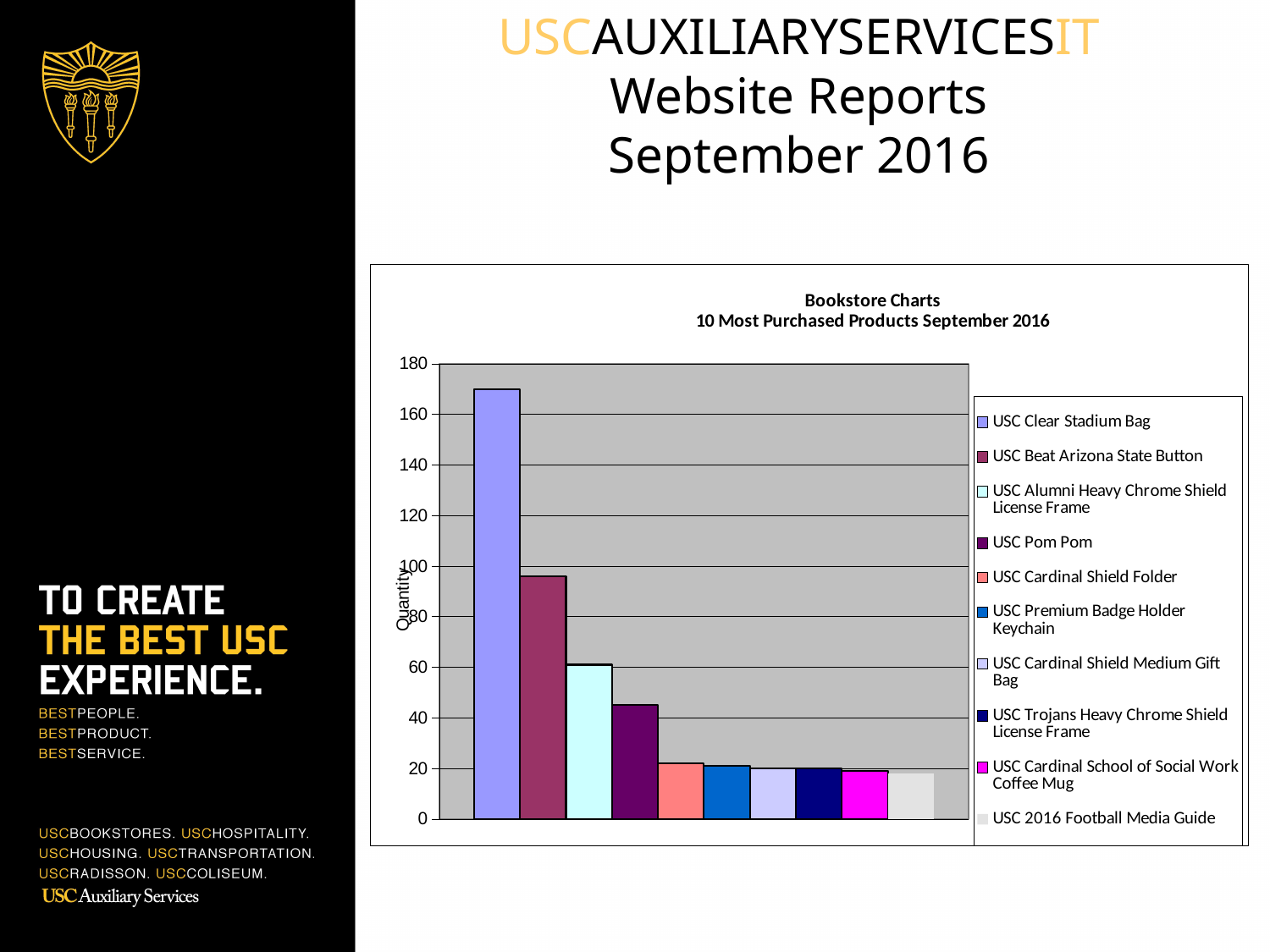
Is the value for USC Pom Pom greater or less than 60? less How many bars are plotted in the chart? 10 How many entries does the chart's legend list? 10 What is the label on the vertical axis of the chart? Quantity Which product has the highest quantity in the chart? USC Clear Stadium Bag Do the bar values rise or fall from left to right across the chart? fall Which has the larger value, USC Beat Arizona State Button or USC Pom Pom? USC Beat Arizona State Button What is the title of the chart? Bookstore Charts 10 Most Purchased Products September 2016 What kind of chart is shown on the slide? bar chart Is the value for USC Clear Stadium Bag greater or less than 160? greater Is the value for USC Beat Arizona State Button greater or less than 80? greater